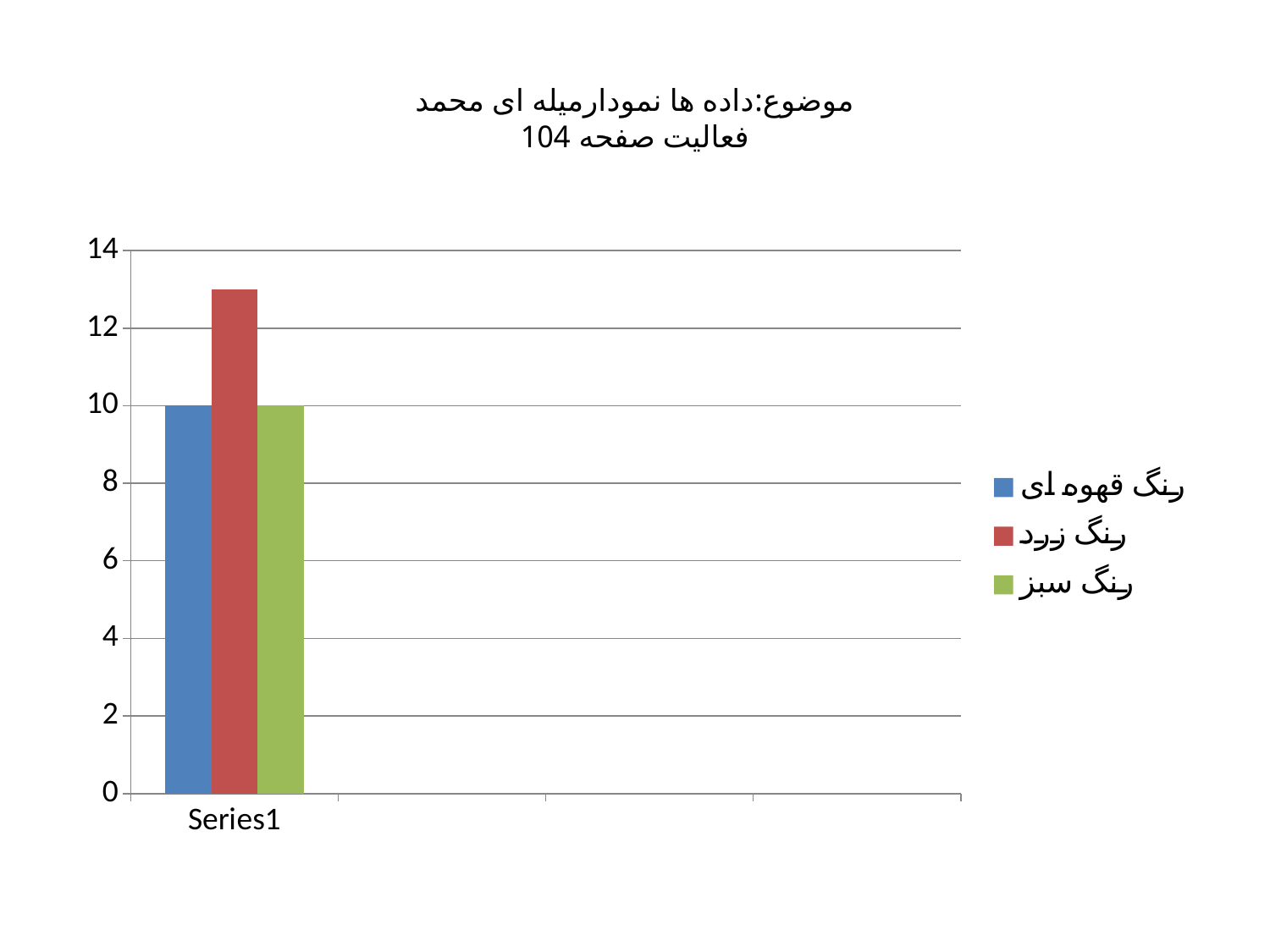
What is the value of the رنگ قهوه ای series for Series1? 10 Which series has the highest value? رنگ زرد What is the label of the category on the x axis? Series1 How many categories are shown on the x axis? 1 What is the value of the رنگ سبز series for Series1? 10 Which is larger, the value for رنگ زرد or the value for رنگ قهوه ای? رنگ زرد Is the value for رنگ زرد greater or less than 12? greater Which series is shown in red in the legend? رنگ زرد How many series does the legend list? 3 What kind of chart is shown on the slide? bar chart Is the value for رنگ زرد greater or less than 14? less